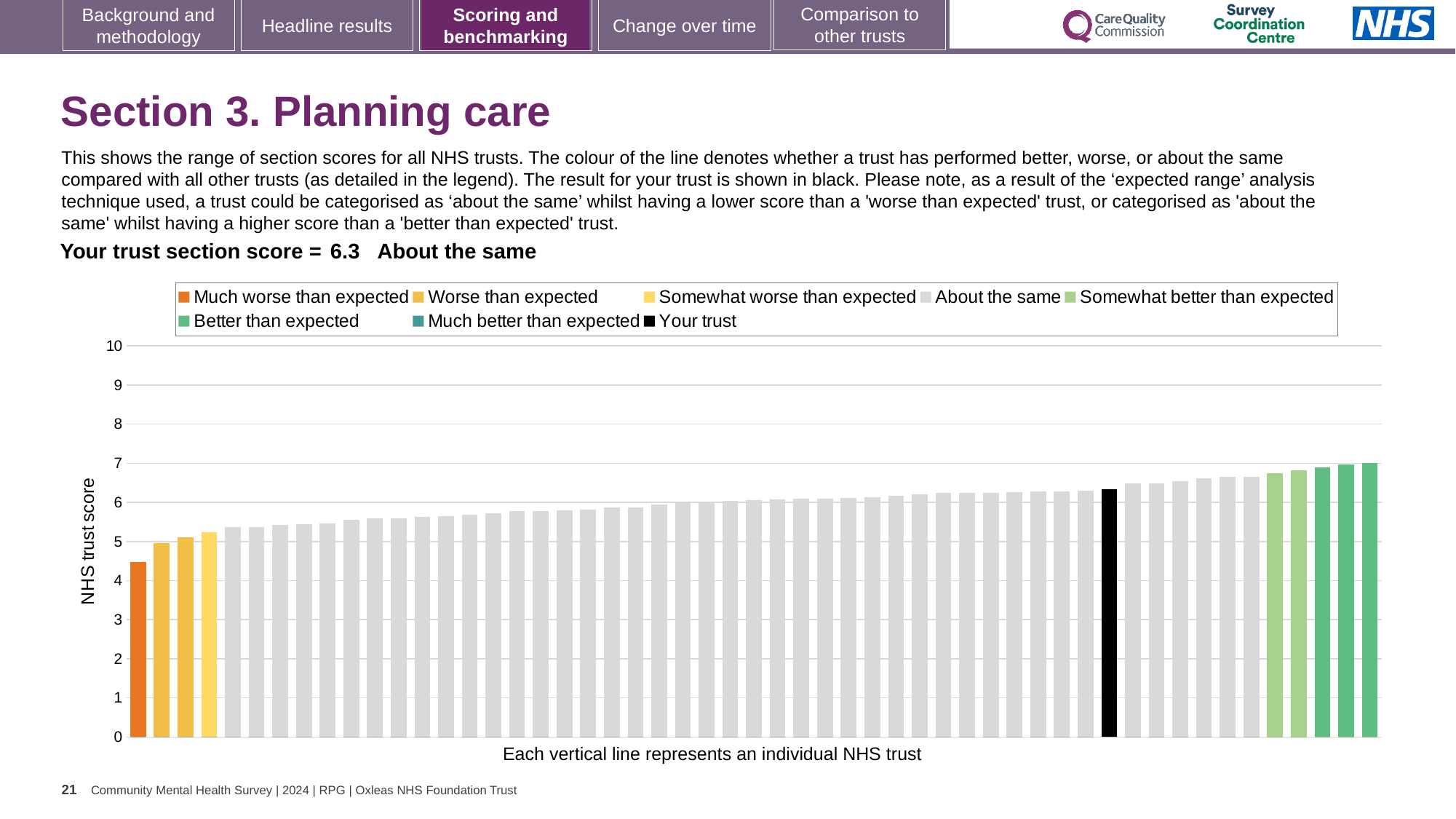
According to the caption below the chart, what does each vertical line represent? An individual NHS trust How many entries does the chart legend list? 8 Is the value of the lowest bar (the orange 'Much worse than expected' trust) greater or less than 5? less Which performance category is your trust placed in for Section 3. Planning care? About the same How many bars are coloured as 'Better than expected'? 3 What is the section score for your trust shown on the slide? 6.3 Do the bar values rise or fall from left to right along the x axis? rise Is the value of the black 'Your trust' bar greater or less than 6? greater Which is larger: the black 'Your trust' bar or the orange 'Much worse than expected' bar? Your trust What kind of chart is shown on the slide? bar chart How many bars are coloured as 'Much worse than expected'? 1 What is the label on the vertical axis of the chart? NHS trust score